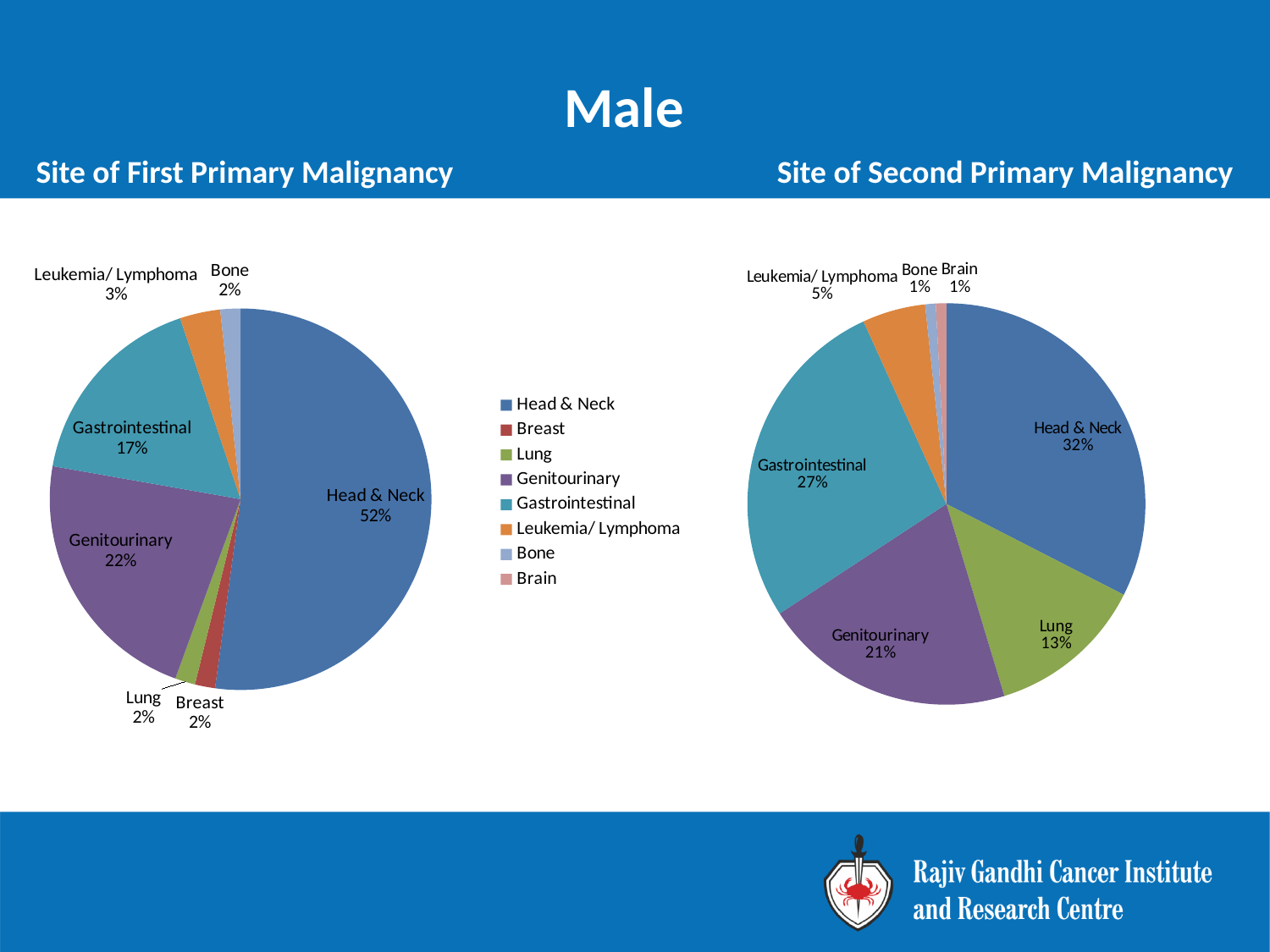
In the Site of First Primary Malignancy chart, what is the difference between Genitourinary and Gastrointestinal? 5% In the Site of Second Primary Malignancy chart, what share does Gastrointestinal have? 27% In the Site of Second Primary Malignancy chart, which is larger, Genitourinary or Gastrointestinal? Gastrointestinal In the Site of Second Primary Malignancy chart, what is the value for Lung? 13% In the Site of Second Primary Malignancy chart, what is the difference between Head & Neck and Genitourinary? 11% How many labelled slices does the Site of Second Primary Malignancy pie have? 7 In the Site of Second Primary Malignancy chart, which site has the largest share? Head & Neck How many entries does the legend list? 8 In the Site of First Primary Malignancy chart, which site has the largest share? Head & Neck In the Site of First Primary Malignancy chart, what share does Head & Neck have? 52% What kind of chart is used for the Site of First Primary Malignancy? Pie chart In the Site of First Primary Malignancy chart, what is the value for Gastrointestinal? 17%